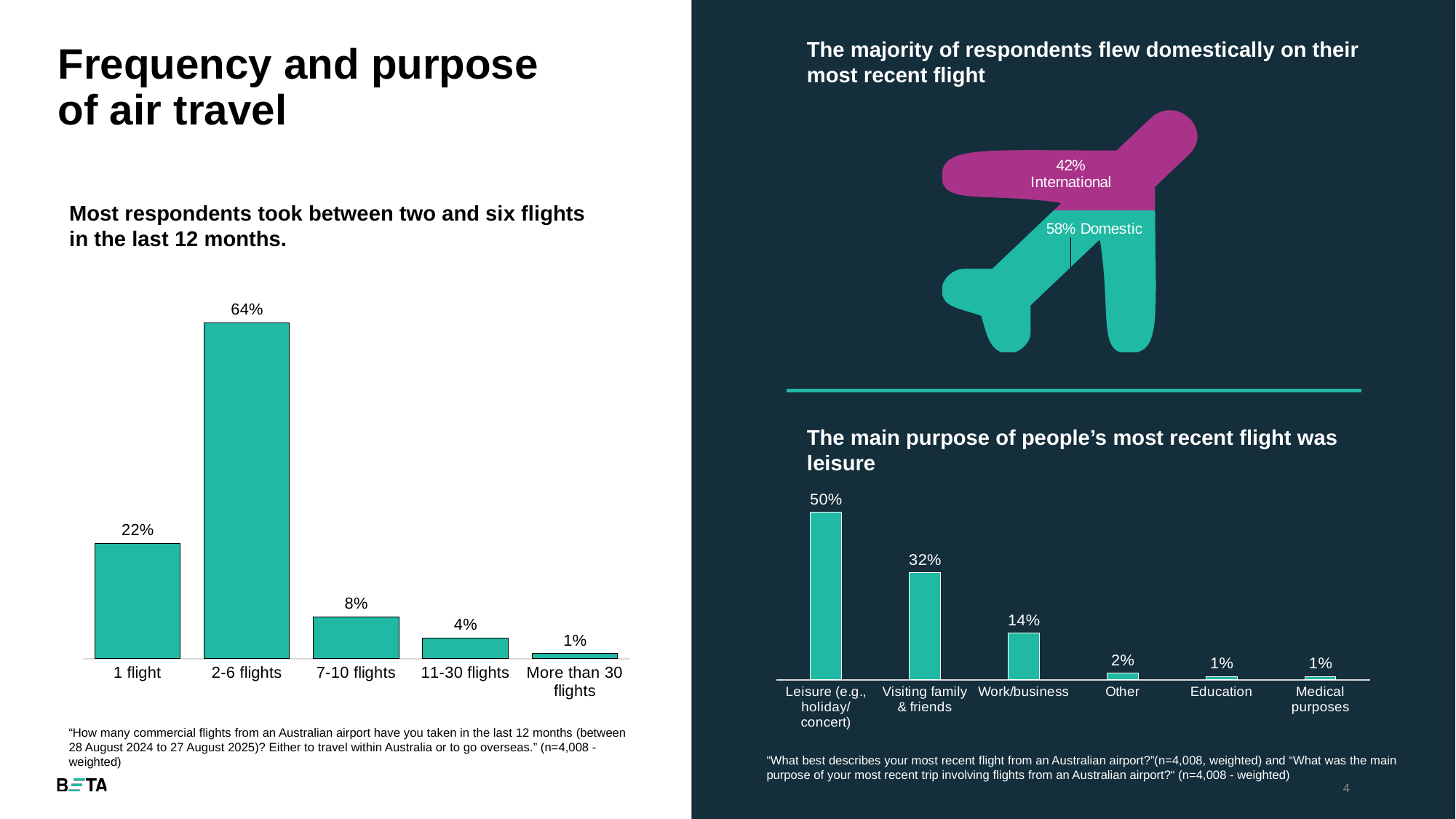
In the bottom-right chart on the purpose of the most recent flight, how many categories are shown? 6 In the bottom-right chart on the purpose of the most recent flight, what percentage is shown for Work/business? 14% In the left-hand chart on flight frequency, how many categories are shown? 5 In the left-hand chart on flight frequency, what percentage of respondents took 1 flight? 22% In the airplane graphic at the top right, what percentage of respondents flew internationally on their most recent flight? 42% In the bottom-right chart on the purpose of the most recent flight, which category has the highest value? Leisure (e.g., holiday/concert) In the left-hand chart on flight frequency, which category has the lowest value? More than 30 flights In the bottom-right chart on the purpose of the most recent flight, what is the difference between Leisure and Visiting family & friends? 18% In the left-hand chart on flight frequency, what is the difference between the values for 2-6 flights and 1 flight? 42% In the left-hand chart on flight frequency, what percentage of respondents took 2-6 flights? 64% In the left-hand chart on flight frequency, what kind of chart is used? Bar chart In the airplane graphic at the top right, which is larger, the Domestic share or the International share? Domestic